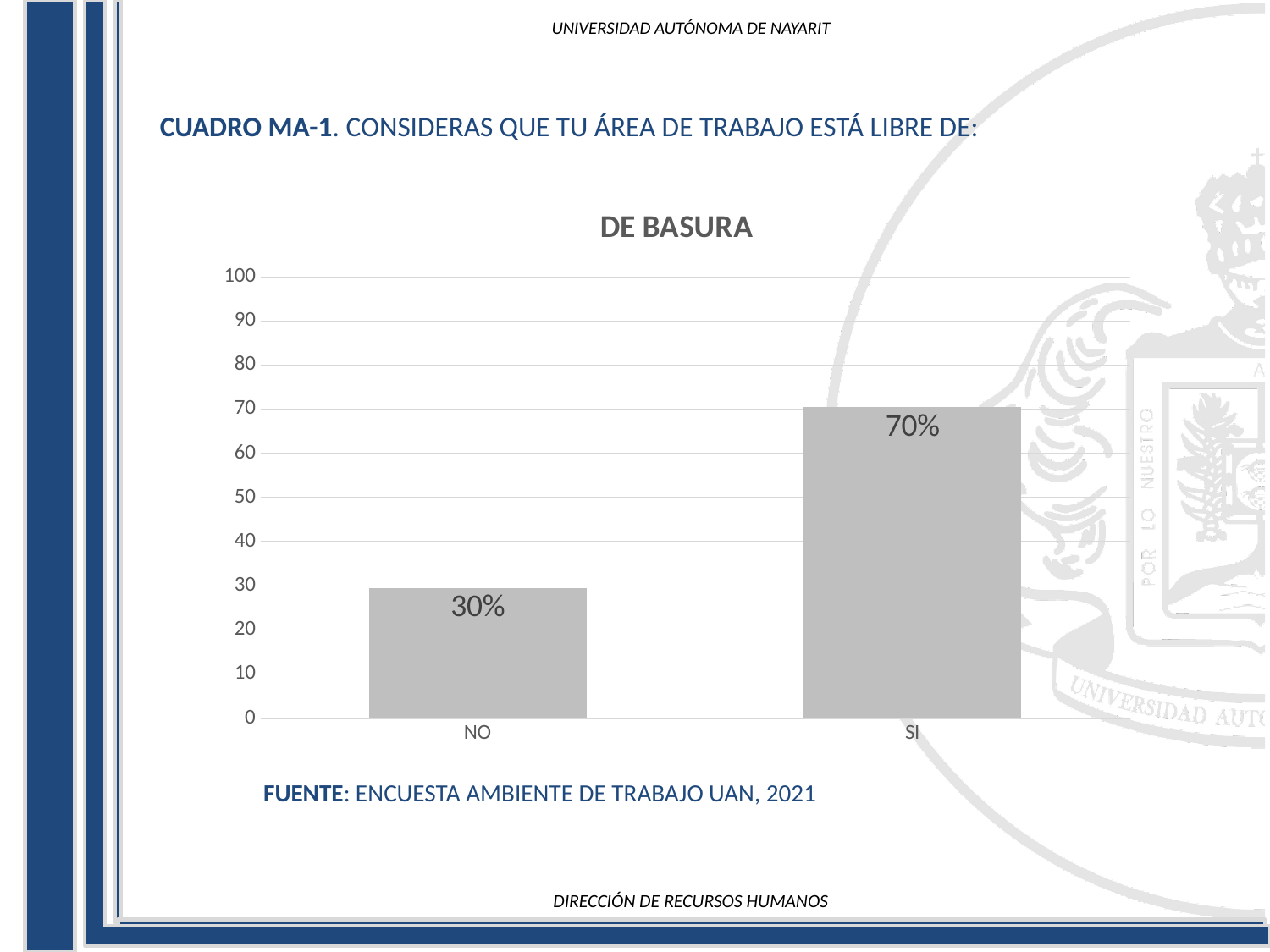
What is the value for NO? 30% Is the value for NO greater or less than 40? less Which category has the lowest value? NO What is the difference between the values for SI and NO? 40% Which category has the highest value? SI What is the title of the chart? DE BASURA How many categories are shown on the x axis? 2 What kind of chart is shown? bar chart What is the value for SI? 70% Is the value for SI greater or less than 50? greater Which is larger, the value for NO or the value for SI? SI What is the maximum value shown on the y axis? 100